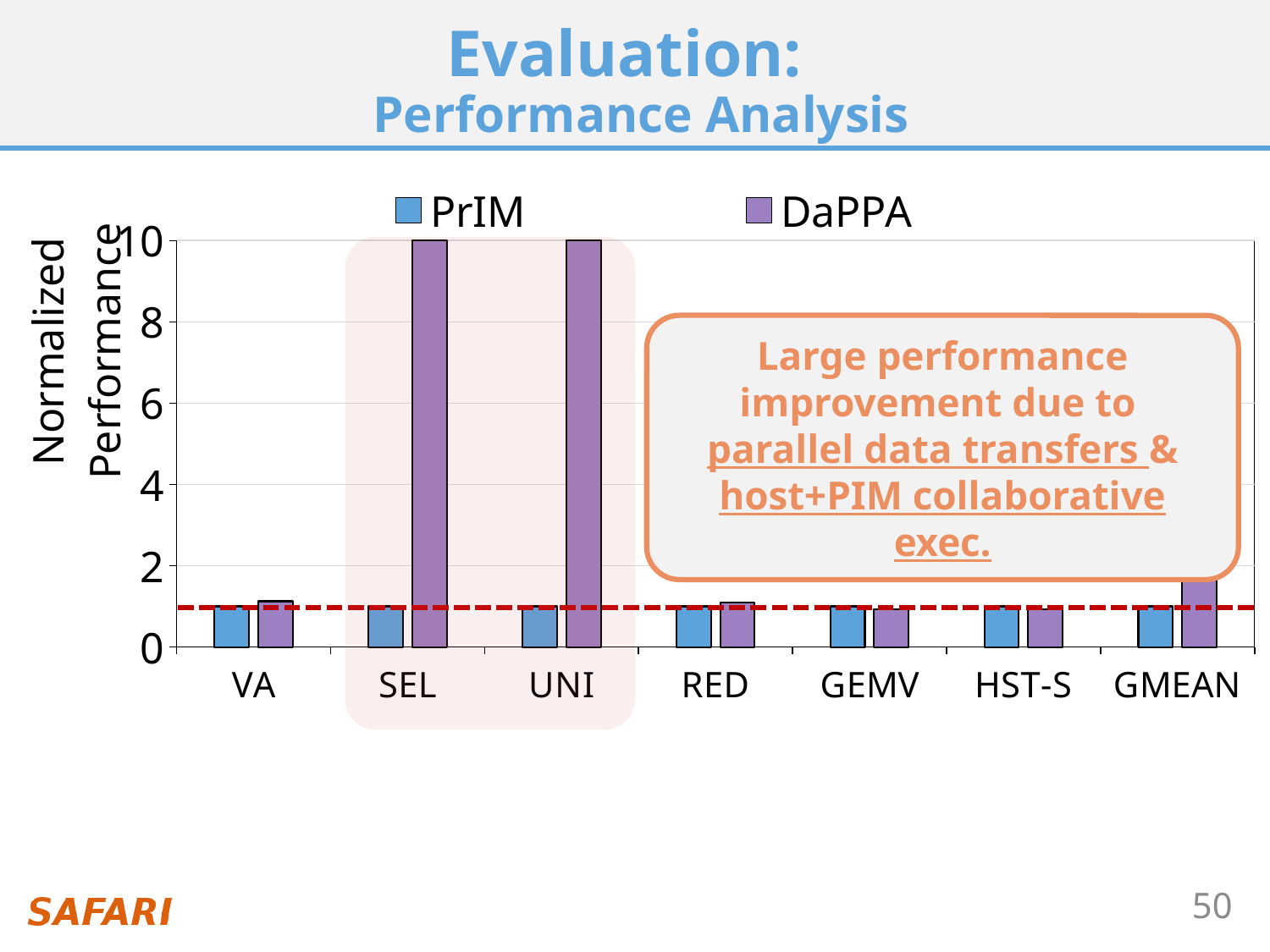
Is the DaPPA value for GMEAN greater or less than 4? less How many series does the legend list? 2 What kind of chart is shown on the slide? bar chart Is the DaPPA value for SEL greater or less than 8? greater Which two series are listed in the legend? PrIM and DaPPA Is the DaPPA value for UNI greater or less than 6? greater Which is larger, the DaPPA value for SEL or the DaPPA value for RED? SEL How many categories are shown along the x axis? 7 Which is larger, the DaPPA value for UNI or the PrIM value for UNI? DaPPA What is the label of the y axis? Normalized Performance